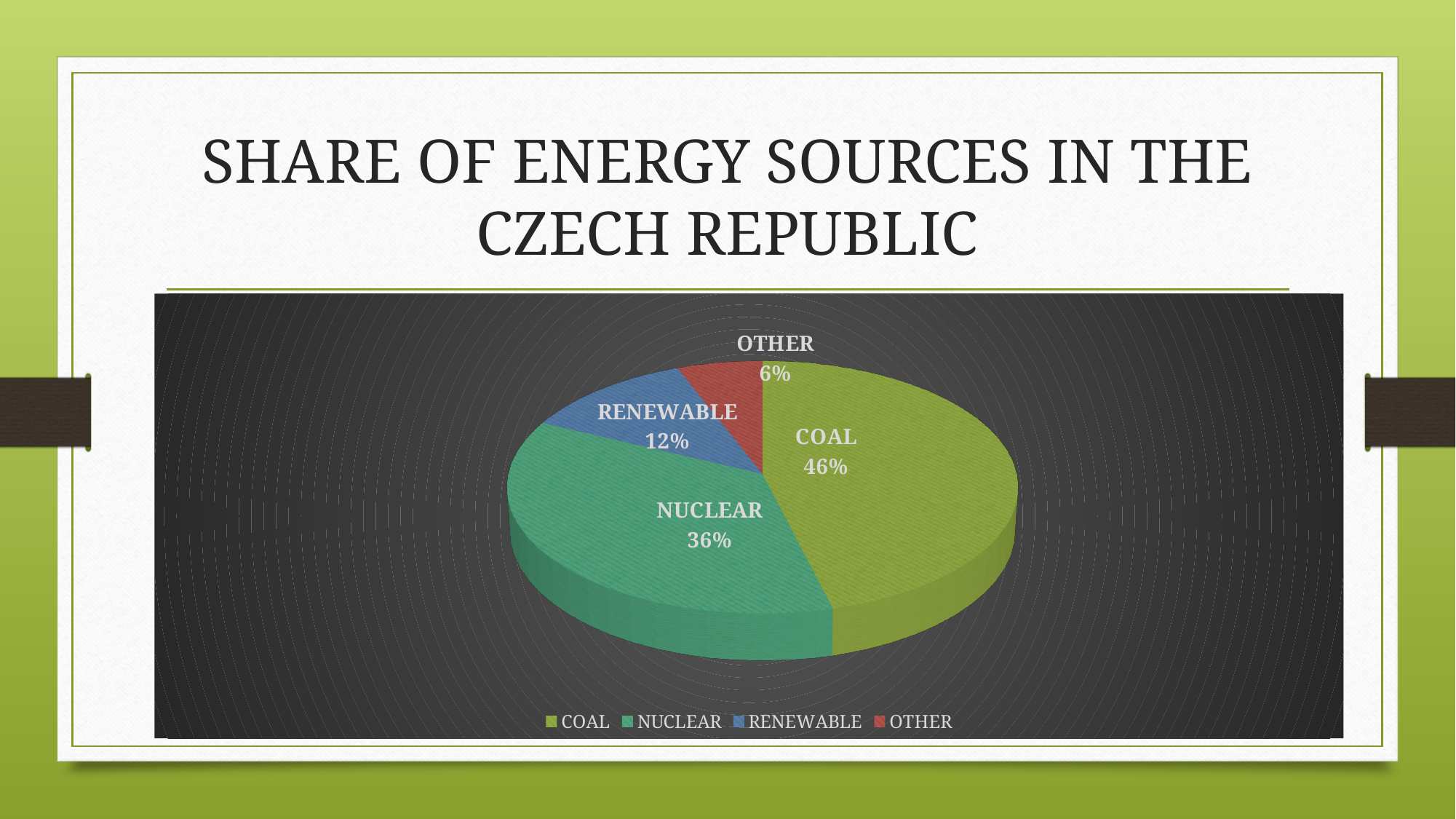
What share of energy sources does nuclear account for? 36% What kind of chart is shown on the slide? Pie chart What share of energy sources does other account for? 6% Which has a larger share, nuclear or renewable? NUCLEAR What share of energy sources does renewable account for? 12% What is the title of the slide containing the chart? SHARE OF ENERGY SOURCES IN THE CZECH REPUBLIC What is the difference in percentage points between the renewable and other shares? 6 How many energy source categories are shown in the pie chart? 4 Which energy source has the largest share? COAL Which energy source has the smallest share? OTHER What is the difference in percentage points between the coal and nuclear shares? 10 What share of energy sources does coal account for? 46%